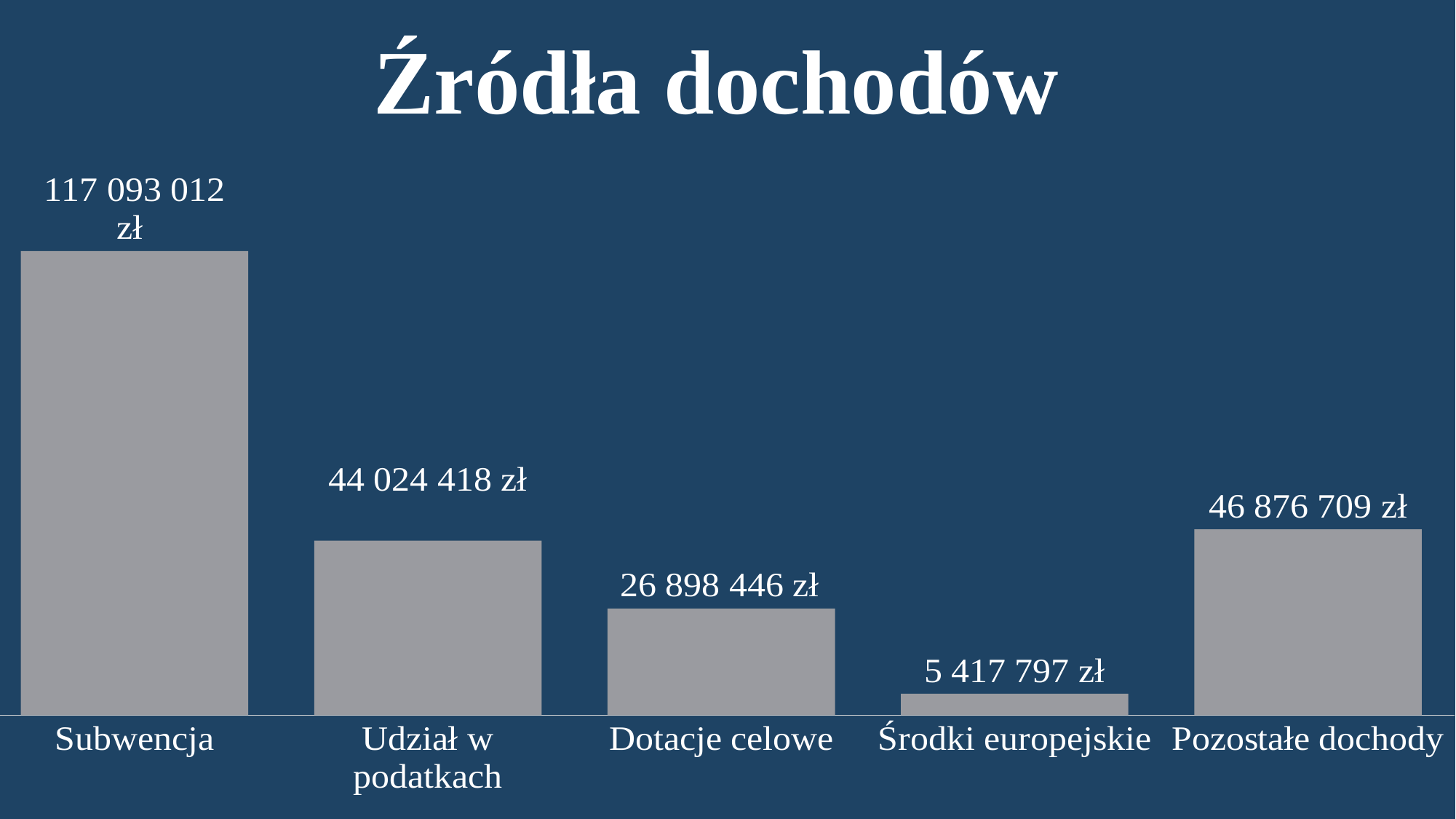
How many categories are shown in the chart? 5 Which is larger, Pozostałe dochody or Udział w podatkach? Pozostałe dochody What is the value for Dotacje celowe? 26 898 446 zł What is the value for Środki europejskie? 5 417 797 zł Which category has the lowest value? Środki europejskie What is the value for Subwencja? 117 093 012 zł What is the difference between Dotacje celowe and Środki europejskie? 21 480 649 zł Which category has the highest value? Subwencja What is the difference between Subwencja and Pozostałe dochody? 70 216 303 zł What is the value for Pozostałe dochody? 46 876 709 zł What is the value for Udział w podatkach? 44 024 418 zł What kind of chart is shown on the slide? Bar chart